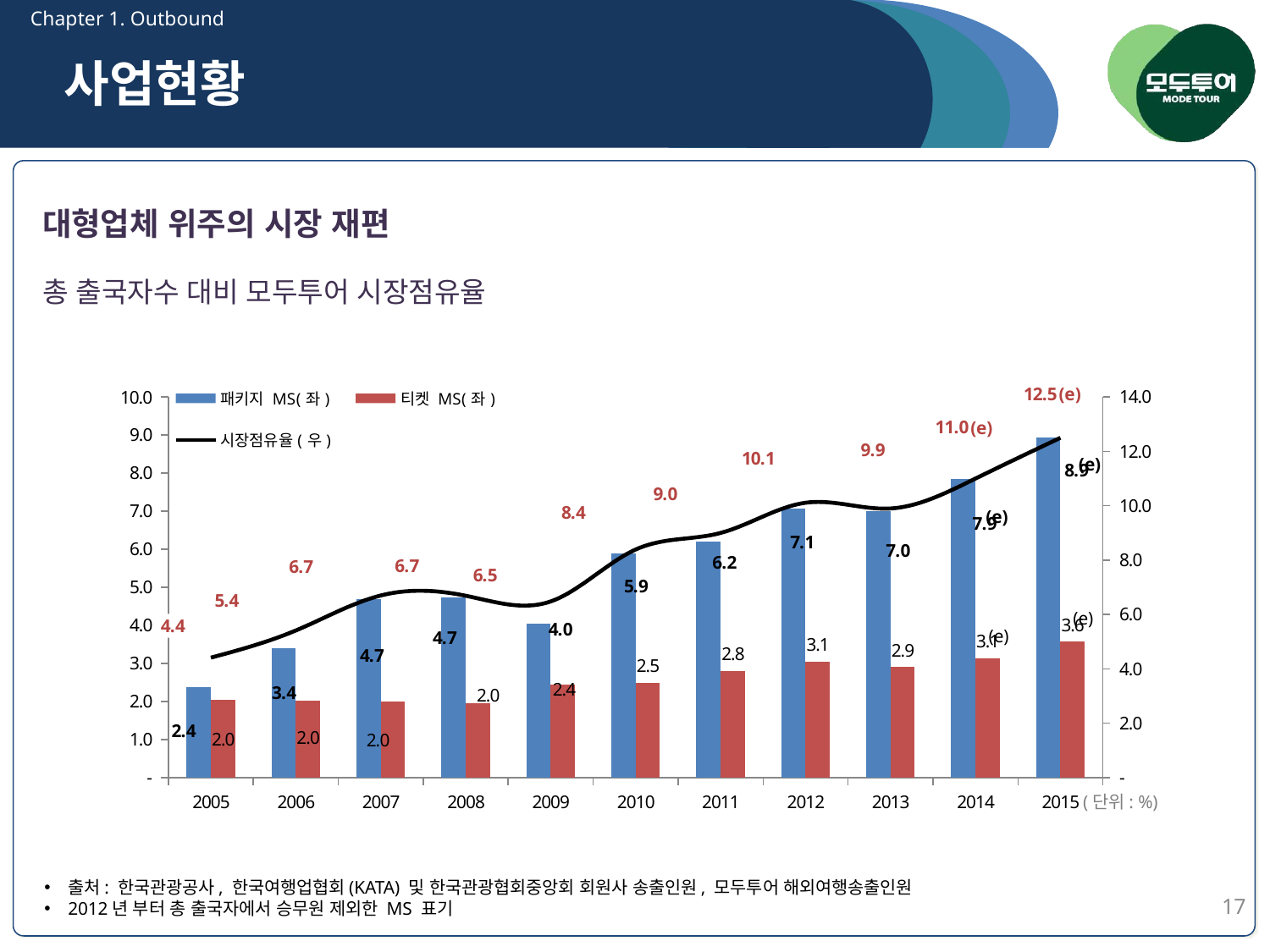
In 2013, which is larger: 패키지 MS or 티켓 MS? 패키지 MS What kind of chart is shown on the slide? Bar chart with a line How many series does the legend list? 3 How many years are shown on the x axis? 11 Does the 시장점유율 line generally rise or fall from 2005 to 2015? Rise What is the difference between the 패키지 MS values for 2012 and 2005? 4.7 What is the 시장점유율 value shown for 2015? 12.5(e) What is the 시장점유율 value for 2011? 9.0 What is the 티켓 MS value for 2012? 3.1 In which year is the 시장점유율 line at its highest? 2015 In which year is the 패키지 MS bar the lowest? 2005 What is the 패키지 MS value for 2010? 5.9